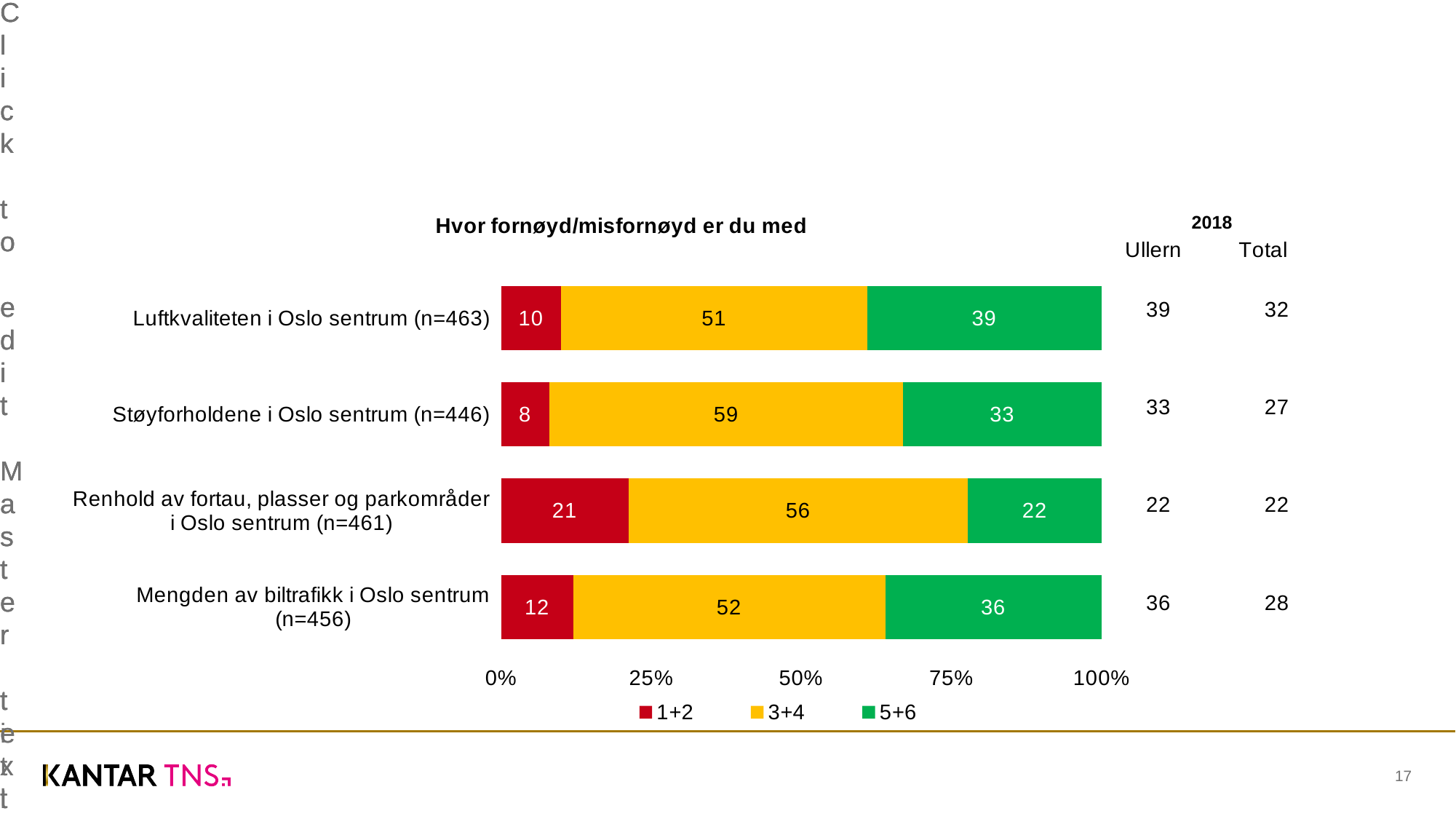
What is the difference between the 5+6 values for "Luftkvaliteten i Oslo sentrum (n=463)" and "Støyforholdene i Oslo sentrum (n=446)"? 6 Which category has the lowest value for the 5+6 series? Renhold av fortau, plasser og parkområder i Oslo sentrum (n=461) What is the title of the chart? Hvor fornøyd/misfornøyd er du med What is the value of the 5+6 series for "Luftkvaliteten i Oslo sentrum (n=463)"? 39 What kind of chart is shown on the slide? Stacked bar chart Which category has the highest value for the 1+2 series? Renhold av fortau, plasser og parkområder i Oslo sentrum (n=461) What is the value of the 3+4 series for "Støyforholdene i Oslo sentrum (n=446)"? 59 How many series does the legend list? 3 How many categories are shown on the chart? 4 What is the value of the 1+2 series for "Renhold av fortau, plasser og parkområder i Oslo sentrum (n=461)"? 21 What is the total of the stacked bar for "Mengden av biltrafikk i Oslo sentrum (n=456)"? 100 Which is larger: the 3+4 value for "Mengden av biltrafikk i Oslo sentrum (n=456)" or the 3+4 value for "Renhold av fortau, plasser og parkområder i Oslo sentrum (n=461)"? Renhold av fortau, plasser og parkområder i Oslo sentrum (n=461)